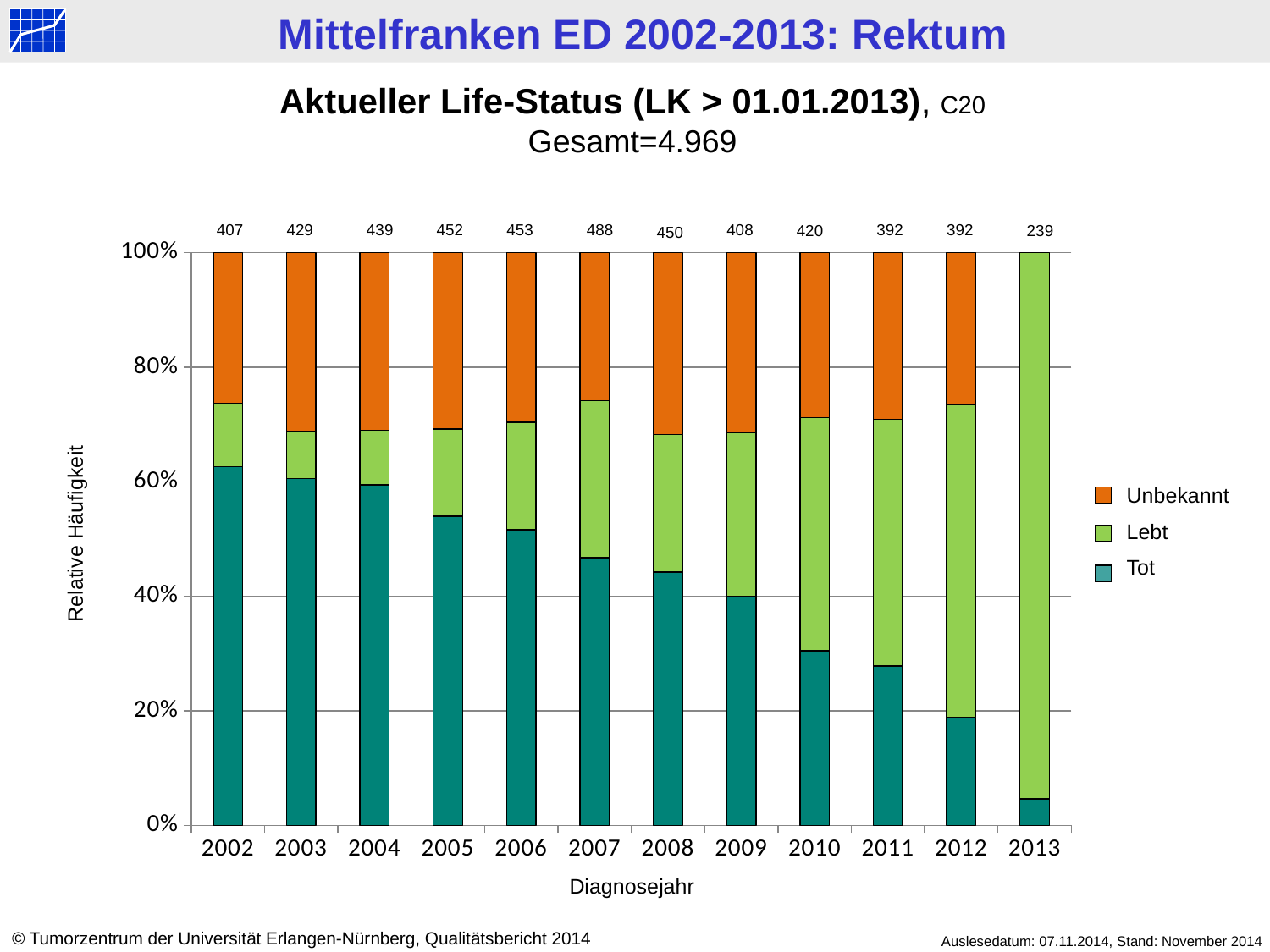
What number is printed above the bar for 2002? 407 How many series does the legend list? 3 Is the share of 'Tot' in 2010 greater or less than 40%? less What is the difference between the numbers printed above the bars for 2007 and 2013? 249 What kind of chart is shown on the slide? stacked bar chart How many diagnosis years are shown on the x axis? 12 Which year has the larger number printed above its bar, 2003 or 2009? 2003 What number is printed above the bar for 2007? 488 Which diagnosis year has the highest number printed above its bar? 2007 Which diagnosis year has the lowest number printed above its bar? 2013 Does the share of 'Tot' rise or fall from 2002 to 2013? fall What number is printed above the bar for 2013? 239